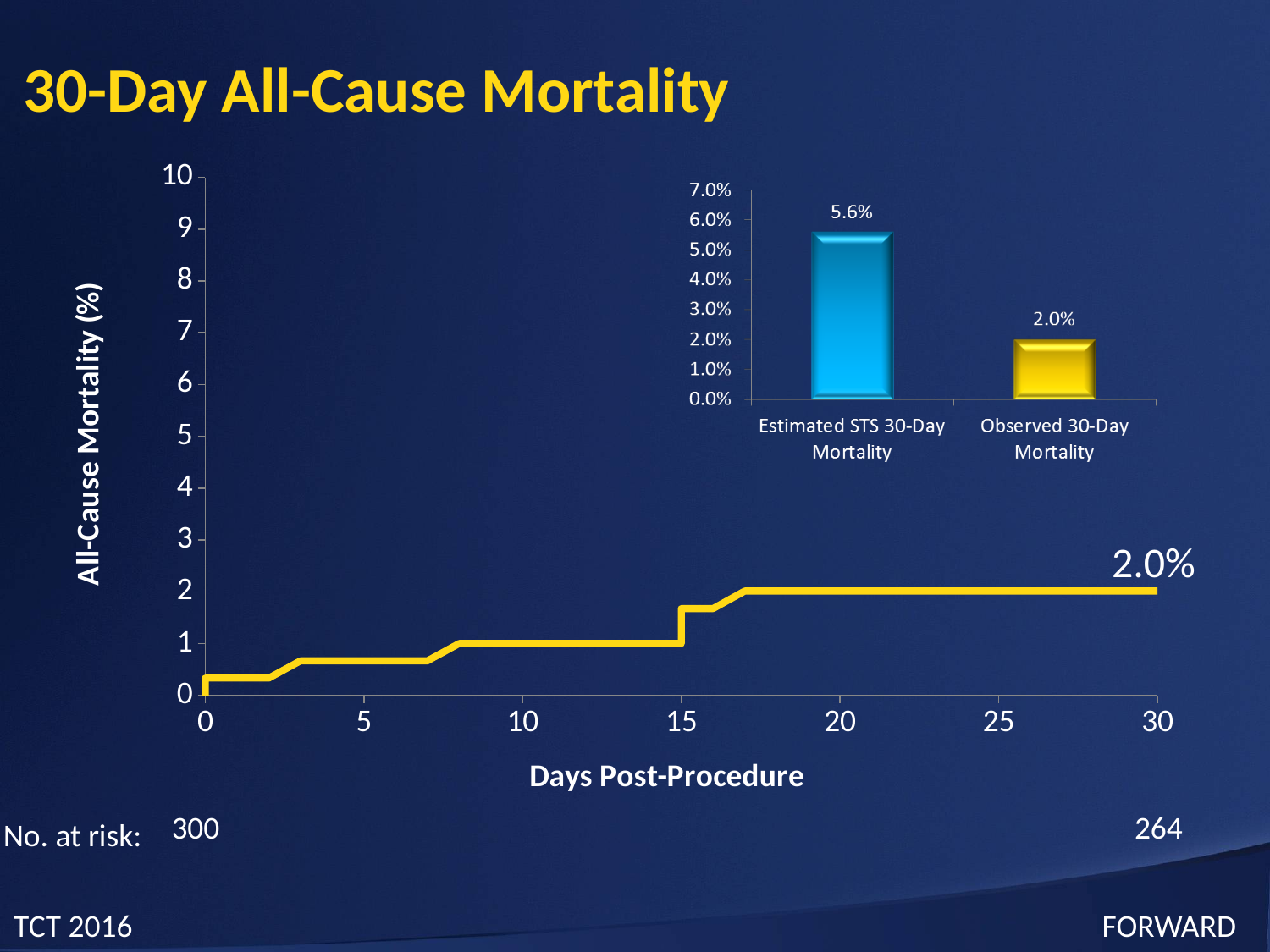
What kind of chart is the inset chart in the upper right? Bar chart In the inset bar chart, what is the value for Observed 30-Day Mortality? 2.0% In the inset bar chart, which category has the higher value? Estimated STS 30-Day Mortality In the inset bar chart, which category has the lower value? Observed 30-Day Mortality In the inset bar chart, what is the difference between Estimated STS 30-Day Mortality and Observed 30-Day Mortality? 3.6% In the large line chart, what is the all-cause mortality value labelled at day 30? 2.0% In the large line chart, is the all-cause mortality value at day 10 greater or less than 2? less What kind of chart is the large chart showing All-Cause Mortality (%) against Days Post-Procedure? Line chart In the inset bar chart, how many categories are shown? 2 What is the x-axis title of the large line chart? Days Post-Procedure In the inset bar chart, what is the value for Estimated STS 30-Day Mortality? 5.6% In the large line chart, does all-cause mortality rise or fall as days post-procedure increase? Rise